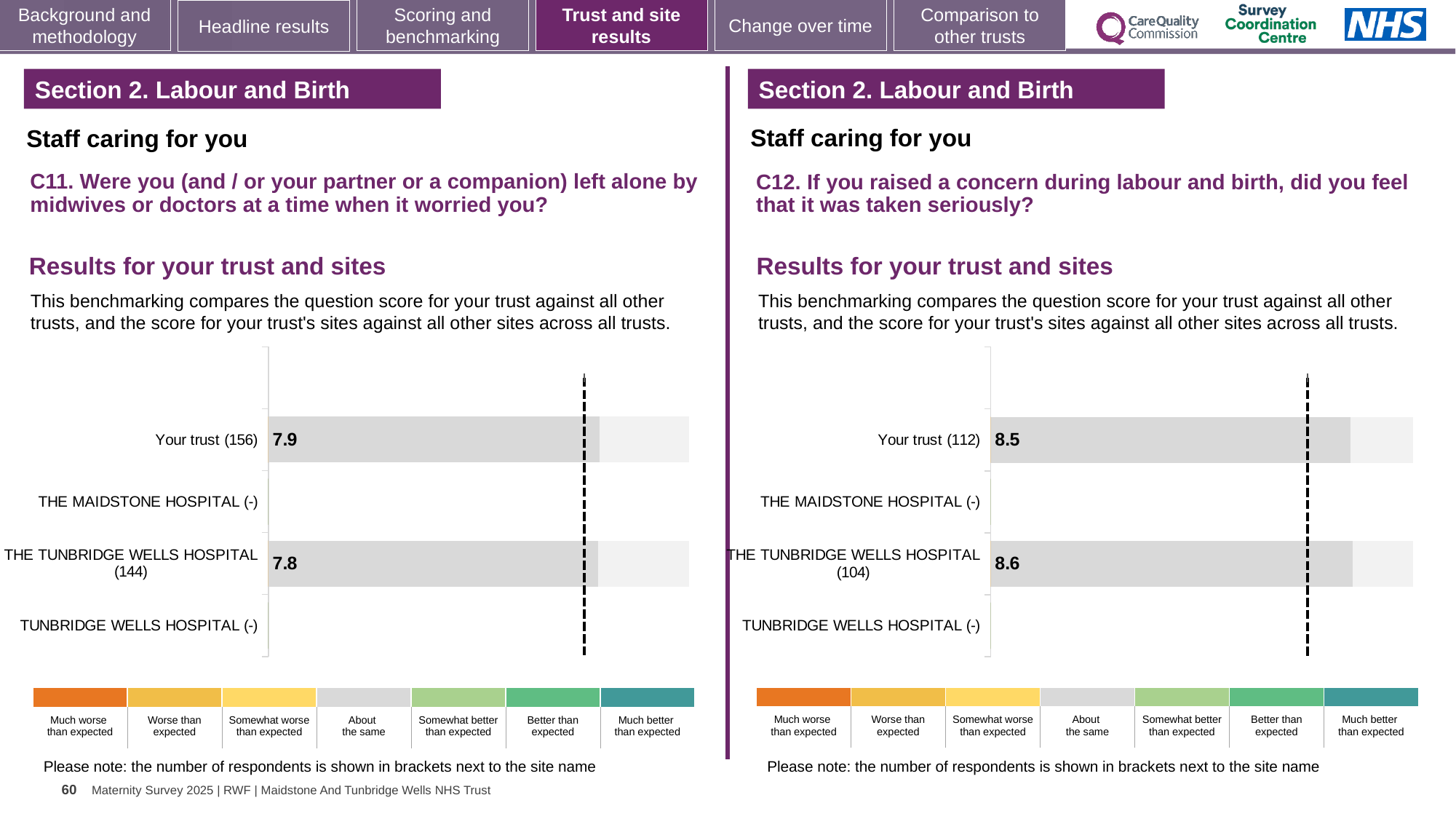
In the C12 chart on the right, how many respondents are shown in brackets for The Tunbridge Wells Hospital? 104 How many categories does the colour key below the C11 chart on the left list? 7 In the C11 chart on the left, how many respondents are shown in brackets for Your trust? 156 What kind of chart is used in the C11 chart on the left? Bar chart In the C12 chart on the right, what is the score for The Tunbridge Wells Hospital? 8.6 In the C11 chart on the left, what is the score for Your trust? 7.9 In the C12 chart on the right, what is the score for Your trust? 8.5 In the C11 chart on the left, what is the score for The Tunbridge Wells Hospital? 7.8 In the C11 chart on the left, what is the difference between the score for Your trust and the score for The Tunbridge Wells Hospital? 0.1 How many site/trust categories are listed on the vertical axis of the C12 chart on the right? 4 In the C11 chart on the left, which has the higher score: Your trust or The Tunbridge Wells Hospital? Your trust In the C12 chart on the right, which has the higher score: Your trust or The Tunbridge Wells Hospital? The Tunbridge Wells Hospital